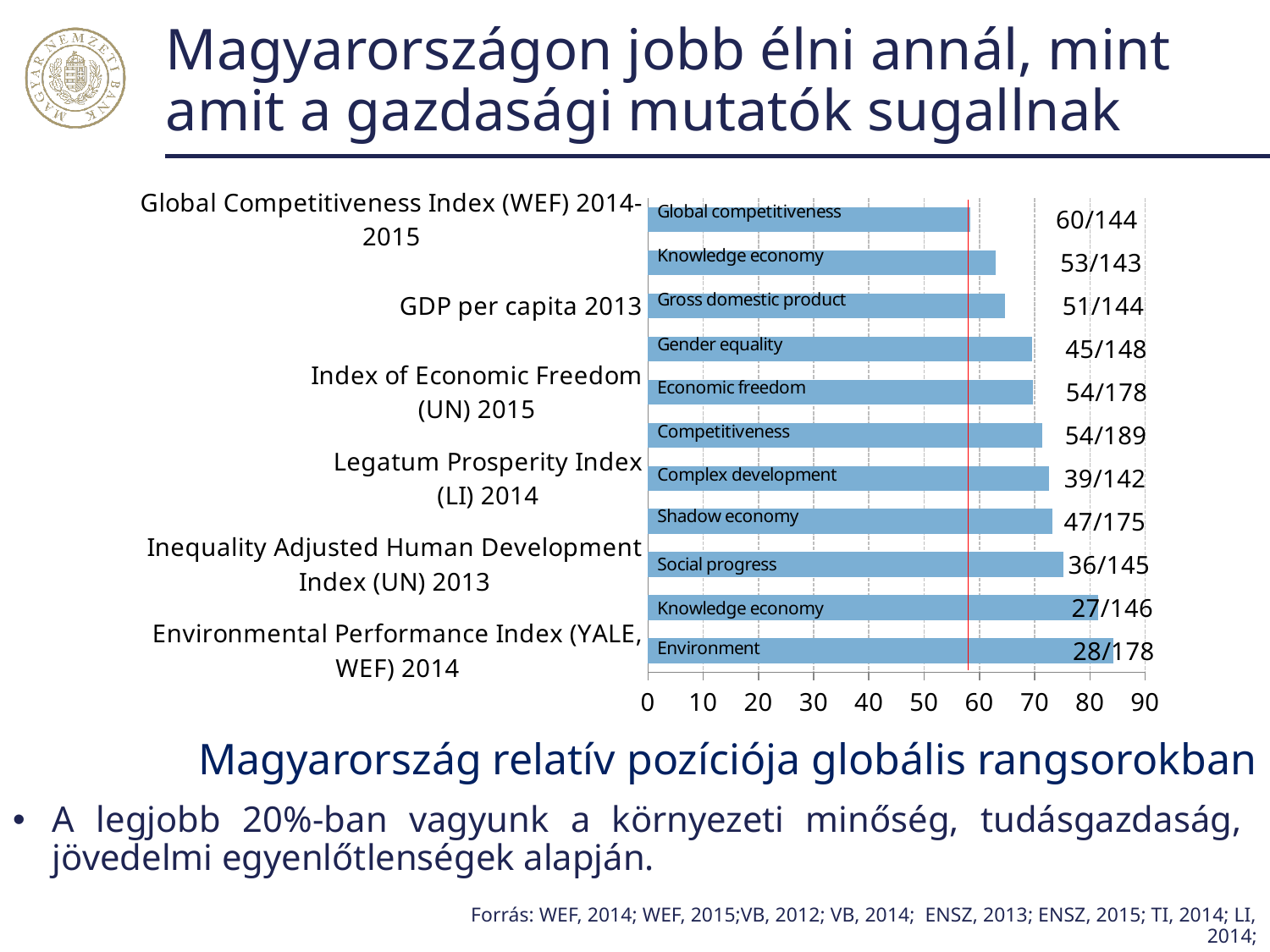
Which category has the shortest bar in the chart? Global competitiveness What kind of chart is shown on the slide? bar chart Is the value for Social progress greater or less than 70? greater Is the value for Global competitiveness greater or less than 60? less What rank label is printed next to the Environment bar? 28/178 What rank label is printed next to the Social progress bar? 36/145 Is the value for Environment greater or less than 80? greater What is the highest value shown on the horizontal axis of the chart? 90 Which bar is longer, Environment or Gross domestic product? Environment Which bar is longer, Social progress or Global competitiveness? Social progress How many bars does the chart contain? 11